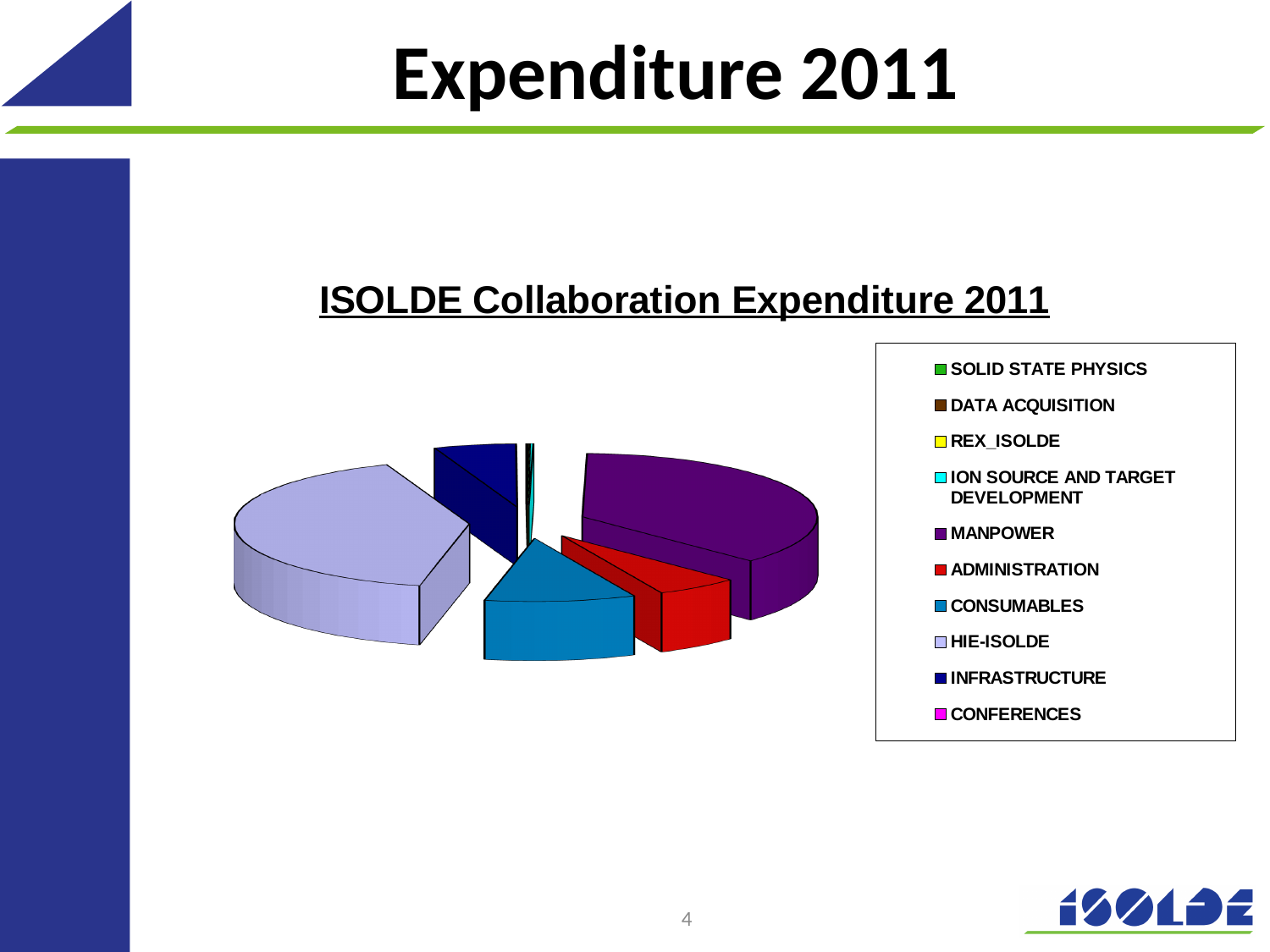
Which is larger, the slice for MANPOWER or the slice for CONSUMABLES? MANPOWER Which is larger, the slice for HIE-ISOLDE or the slice for INFRASTRUCTURE? HIE-ISOLDE What is the title of the chart? ISOLDE Collaboration Expenditure 2011 How many categories does the legend of the pie chart list? 10 Which is larger, the slice for HIE-ISOLDE or the slice for CONSUMABLES? HIE-ISOLDE What kind of chart is shown on the slide? pie chart What colour represents MANPOWER in the pie chart? purple